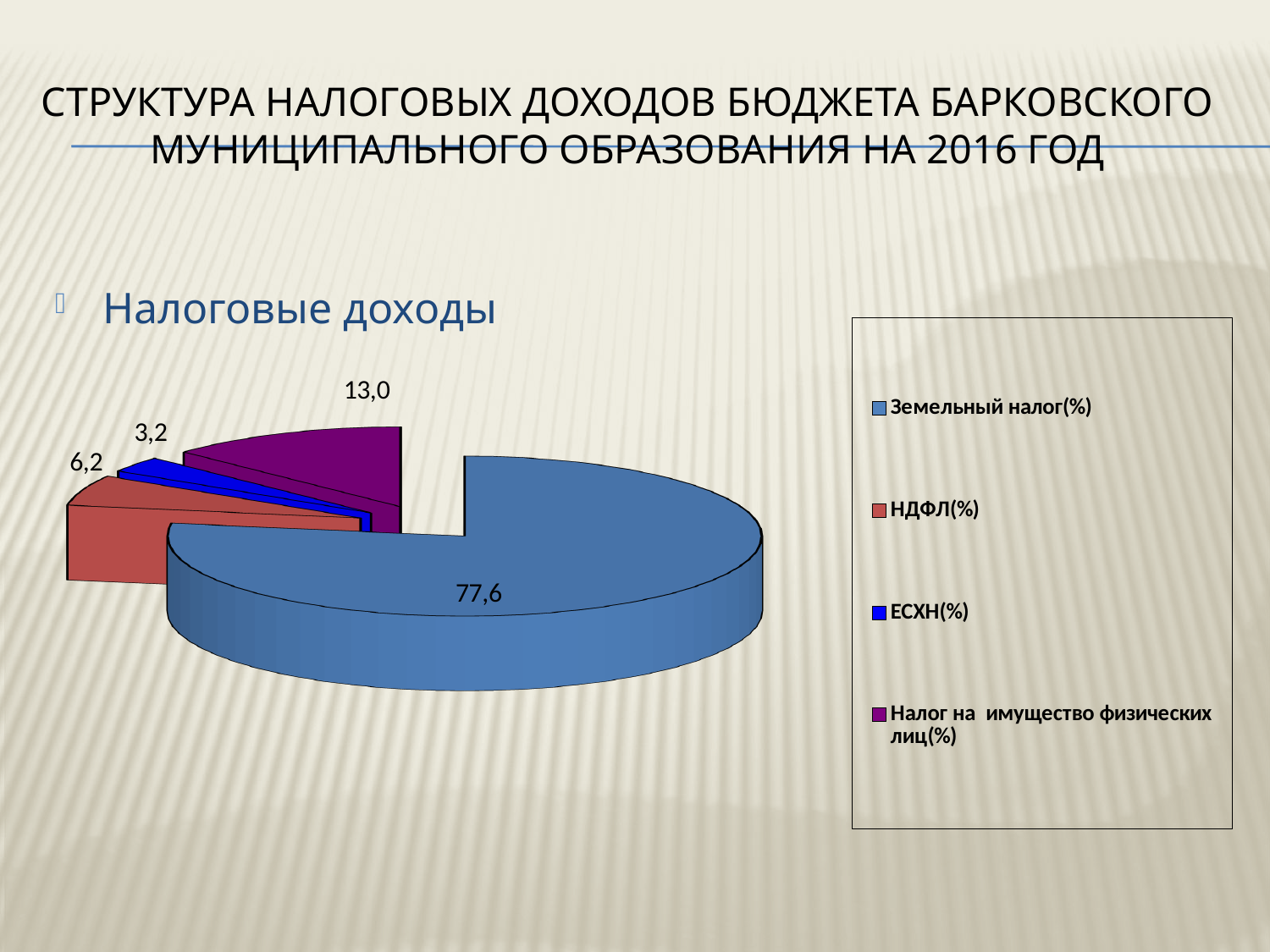
What is the value for ЕСХН(%) in the pie chart? 3,2 What type of chart is shown on the slide? Pie chart Which category has the smallest slice in the pie chart? ЕСХН(%) Which category has the largest slice in the pie chart? Земельный налог(%) What colour is the slice for Налог на имущество физических лиц(%)? Purple What is the value for Земельный налог(%) in the pie chart? 77,6 Which is larger: the value for НДФЛ(%) or the value for Налог на имущество физических лиц(%)? Налог на имущество физических лиц(%) What is the value for НДФЛ(%) in the pie chart? 6,2 How many slices does the pie chart have? 4 What is the difference between the values for НДФЛ(%) and ЕСХН(%)? 3,0 What is the difference between the values for Земельный налог(%) and Налог на имущество физических лиц(%)? 64,6 What is the value for Налог на имущество физических лиц(%) in the pie chart? 13,0